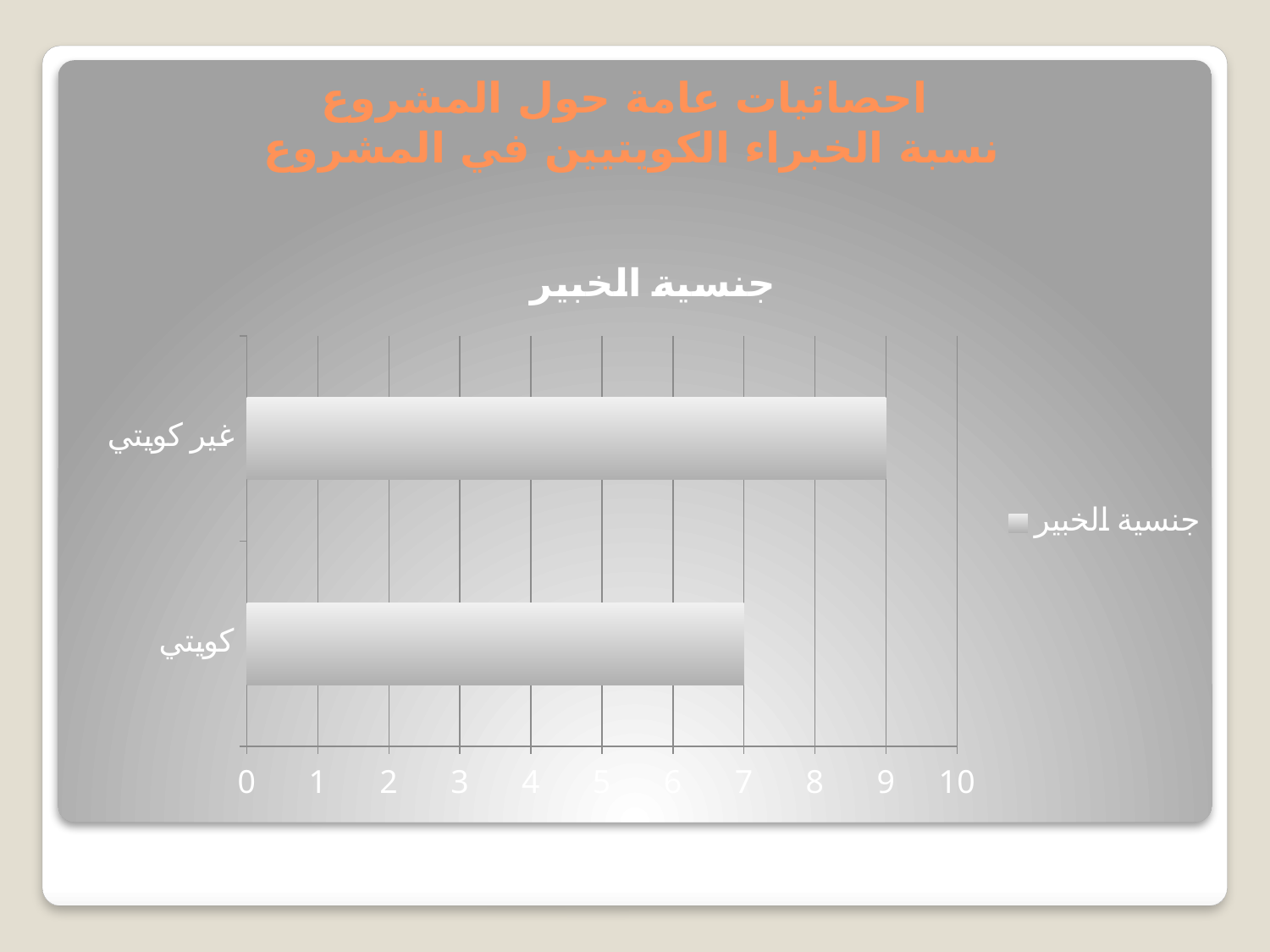
Is the value for كويتي greater or less than 8? less What is the value for كويتي? 7 What is the title of the chart? جنسية الخبير Which category has the highest value? غير كويتي What kind of chart is shown on the slide? bar chart Which category has the lowest value? كويتي Is the value for غير كويتي greater or less than 8? greater What is the difference between the values for غير كويتي and كويتي? 2 What is the value for غير كويتي? 9 How many categories are shown in the chart? 2 How many series does the legend list? 1 Which is larger, the value for كويتي or the value for غير كويتي? غير كويتي